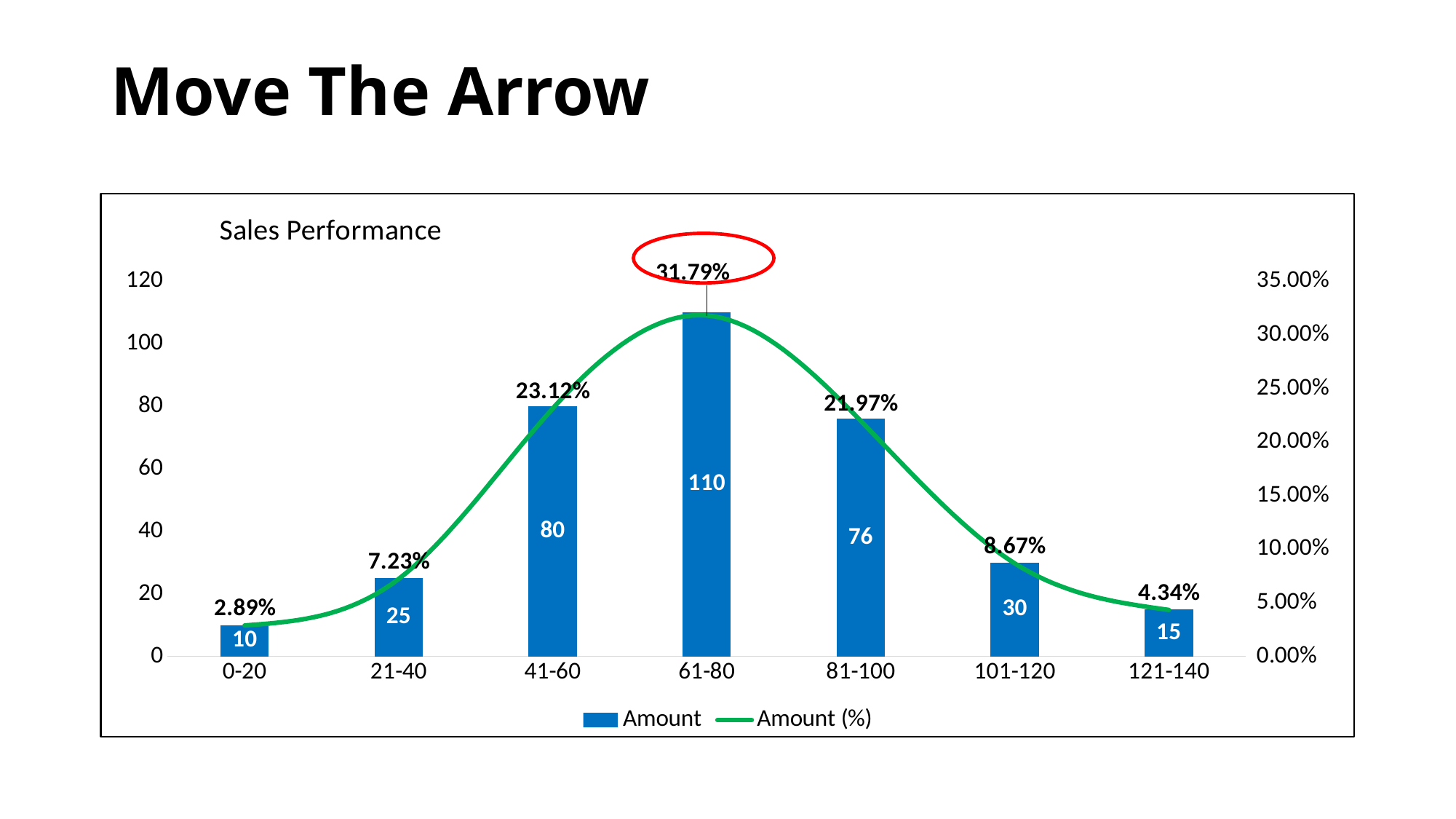
What is the difference in Amount between the 41-60 and 81-100 categories? 4 Which category has the highest Amount? 61-80 What is the Amount for the 61-80 category? 110 Which category has the lowest Amount (%)? 0-20 How many categories are shown on the x axis? 7 What is the Amount for the 121-140 category? 15 What is the Amount (%) value for the 41-60 category? 23.12% Do the Amount values rise or fall from 61-80 to 121-140? Fall How many series does the legend list? 2 What kind of chart is shown? Combined bar and line chart Which has a larger Amount, 21-40 or 101-120? 101-120 What is the title of the chart? Sales Performance